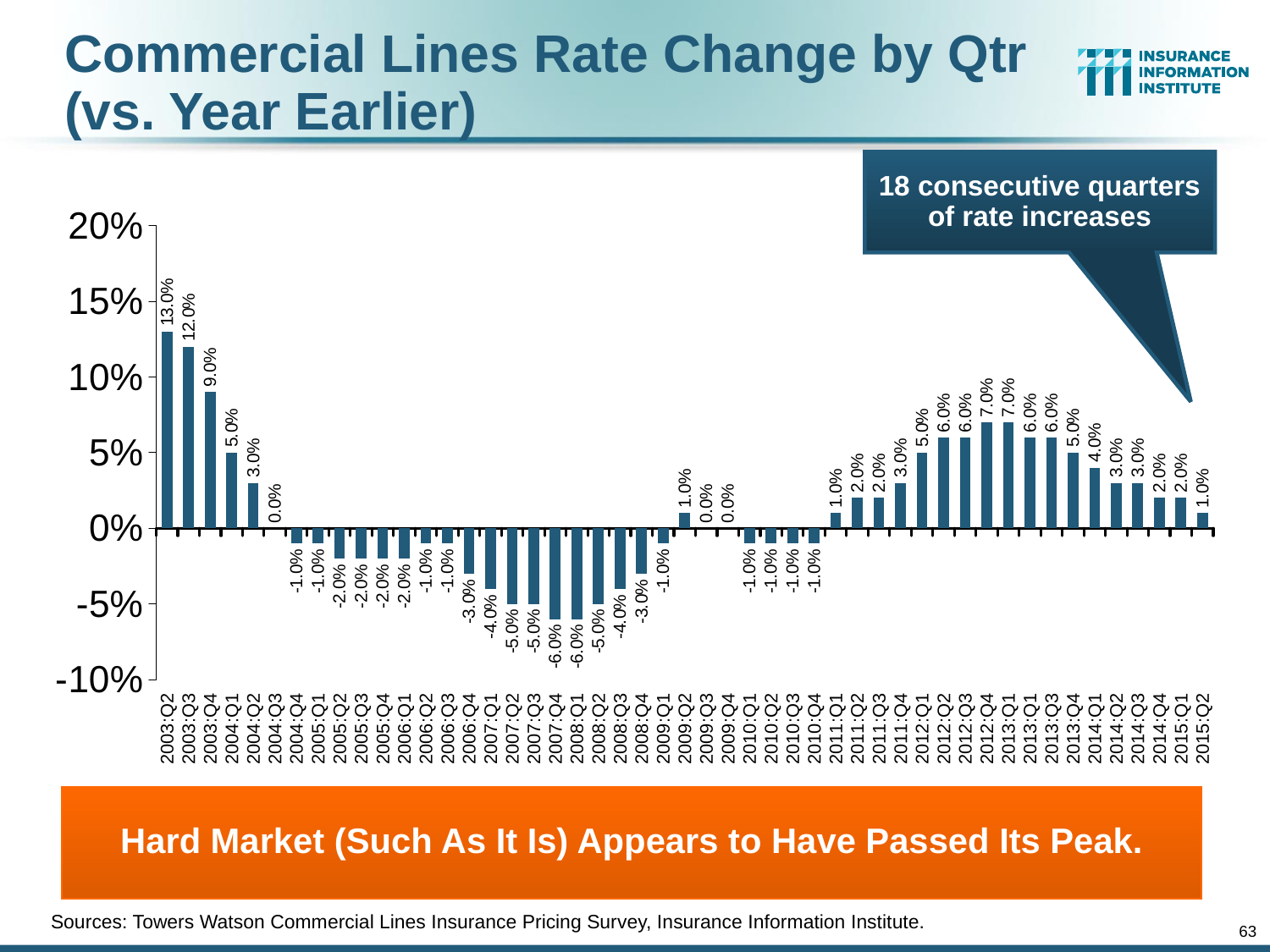
What is the rate change shown for 2008:Q1? -6.0% What is the rate change shown for 2012:Q4? 7.0% Which quarter has the highest rate change on the chart? 2003:Q2 What is the lowest rate change value shown on the chart? -6.0% How many quarters are plotted on the chart? 49 Is the value for 2003:Q4 greater or less than 5%? greater Do the values rise or fall from 2013:Q1 to 2015:Q2? Fall What is the difference between the rate change in 2003:Q2 and 2003:Q3? 1.0% Which is larger, the rate change for 2012:Q1 or for 2014:Q1? 2012:Q1 What is the rate change shown for 2015:Q2? 1.0% What kind of chart is shown on the slide? Bar chart What is the rate change shown for 2003:Q2? 13.0%